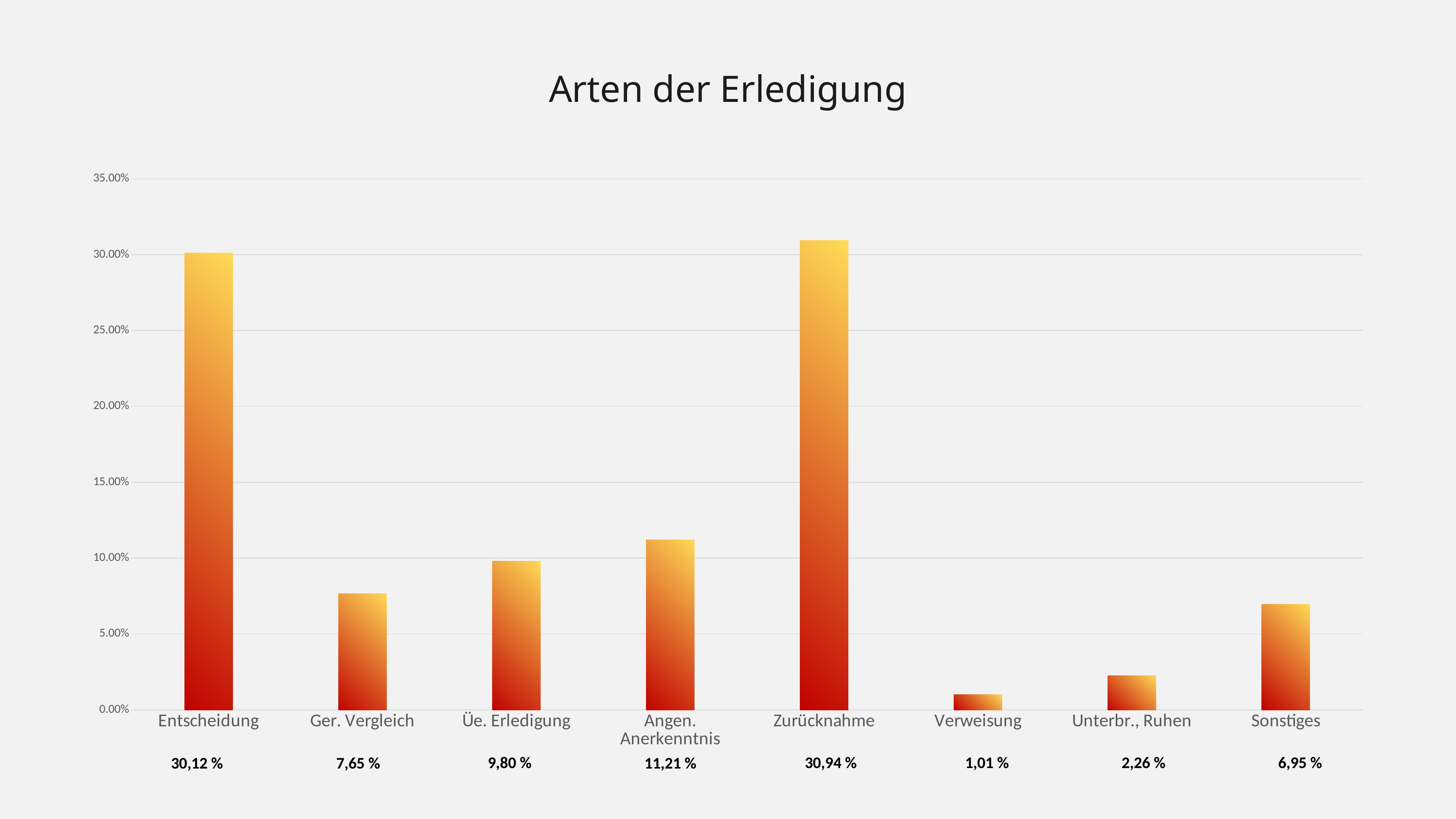
Which category has the lowest value? Verweisung What is the difference between the values for Zurücknahme and Entscheidung? 0,82 % What is the value for Zurücknahme? 30,94 % Is the value for Üe. Erledigung greater or less than 10.00%? less What is the difference between the values for Angen. Anerkenntnis and Üe. Erledigung? 1,41 % Which is larger, the value for Ger. Vergleich or the value for Sonstiges? Ger. Vergleich Which category has the highest value? Zurücknahme What is the value for Entscheidung? 30,12 % What is the value for Angen. Anerkenntnis? 11,21 % What kind of chart is shown on the slide? bar chart What is the value for Unterbr., Ruhen? 2,26 % How many categories are shown in the chart? 8